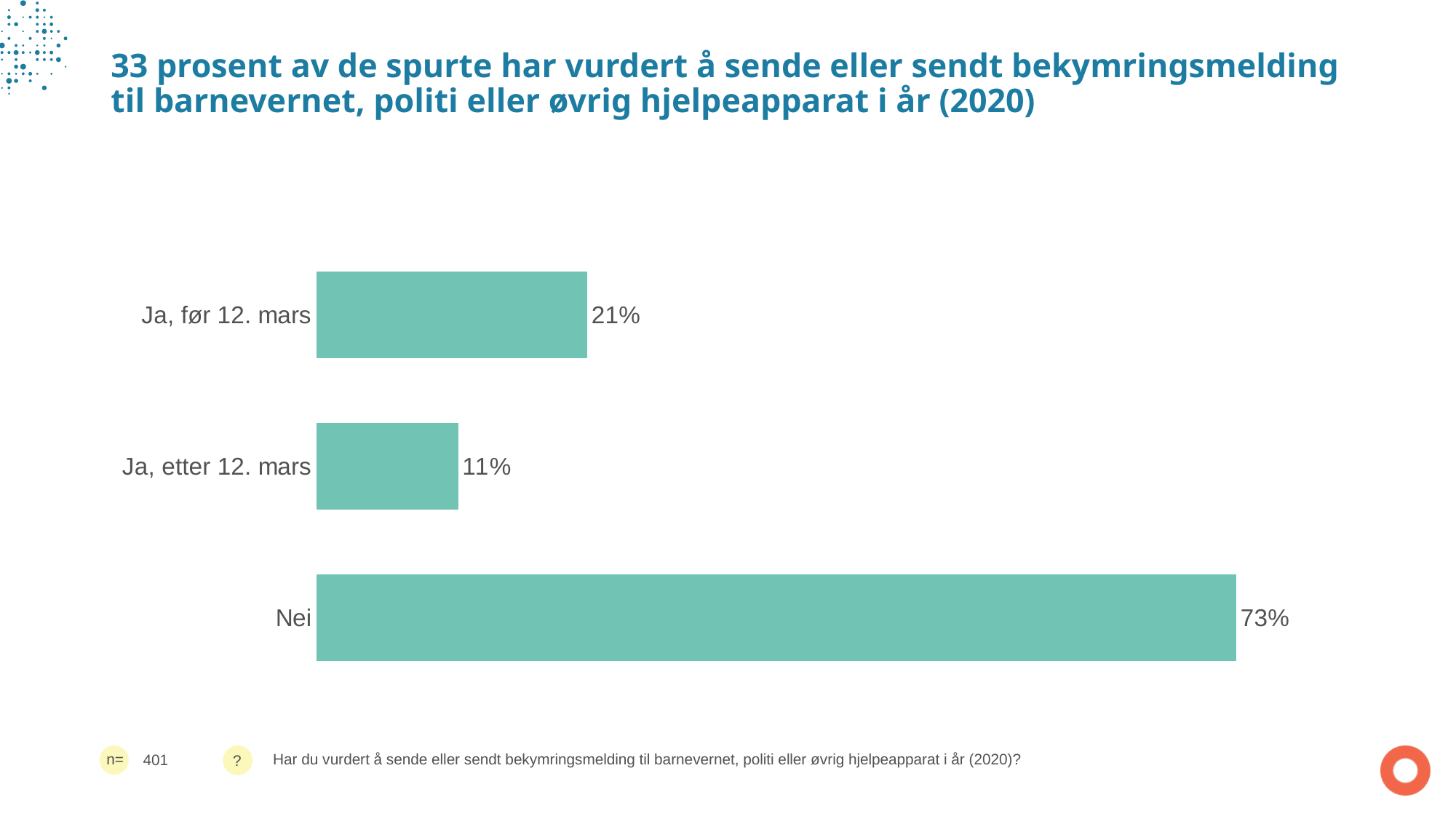
What is the value for "Nei"? 73% Which is larger, the value for "Ja, før 12. mars" or "Ja, etter 12. mars"? Ja, før 12. mars What is the value for "Ja, før 12. mars"? 21% What is the value for "Ja, etter 12. mars"? 11% Which category has the highest value? Nei Which category has the lowest value? Ja, etter 12. mars What colour are the bars in the chart? Teal (green) What is the sample size (n) shown on the slide? 401 What is the difference between the values for "Nei" and "Ja, før 12. mars"? 52% What kind of chart is shown on the slide? Bar chart How many categories are shown in the chart? 3 What is the difference between the values for "Ja, før 12. mars" and "Ja, etter 12. mars"? 10%